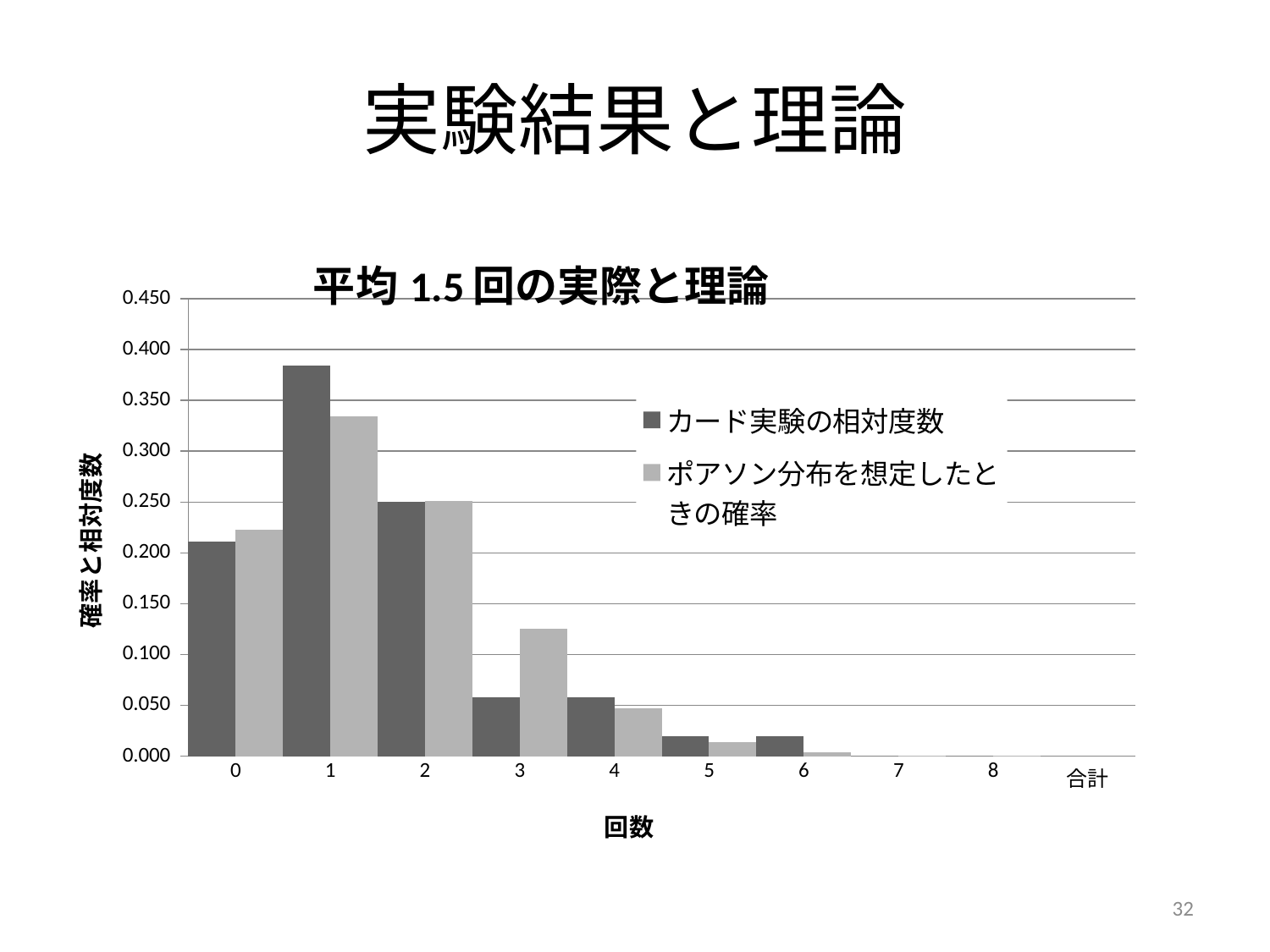
Is the value of カード実験の相対度数 at 回数 = 1 greater or less than 0.350? greater How many series does the legend list? 2 What kind of chart is shown on the slide? bar chart At 回数 = 1, which series has the larger value, カード実験の相対度数 or ポアソン分布を想定したときの確率? カード実験の相対度数 What is the label of the x axis? 回数 For the series ポアソン分布を想定したときの確率, which 回数 category has the highest value? 1 What is the title of the chart? 平均 1.5 回の実際と理論 How many categories are shown on the x axis? 10 At 回数 = 3, which series has the larger value, カード実験の相対度数 or ポアソン分布を想定したときの確率? ポアソン分布を想定したときの確率 Do the values of ポアソン分布を想定したときの確率 rise or fall from 回数 = 1 to 回数 = 6? fall For the series カード実験の相対度数, which 回数 category has the highest value? 1 Is the value of ポアソン分布を想定したときの確率 at 回数 = 3 greater or less than 0.100? greater